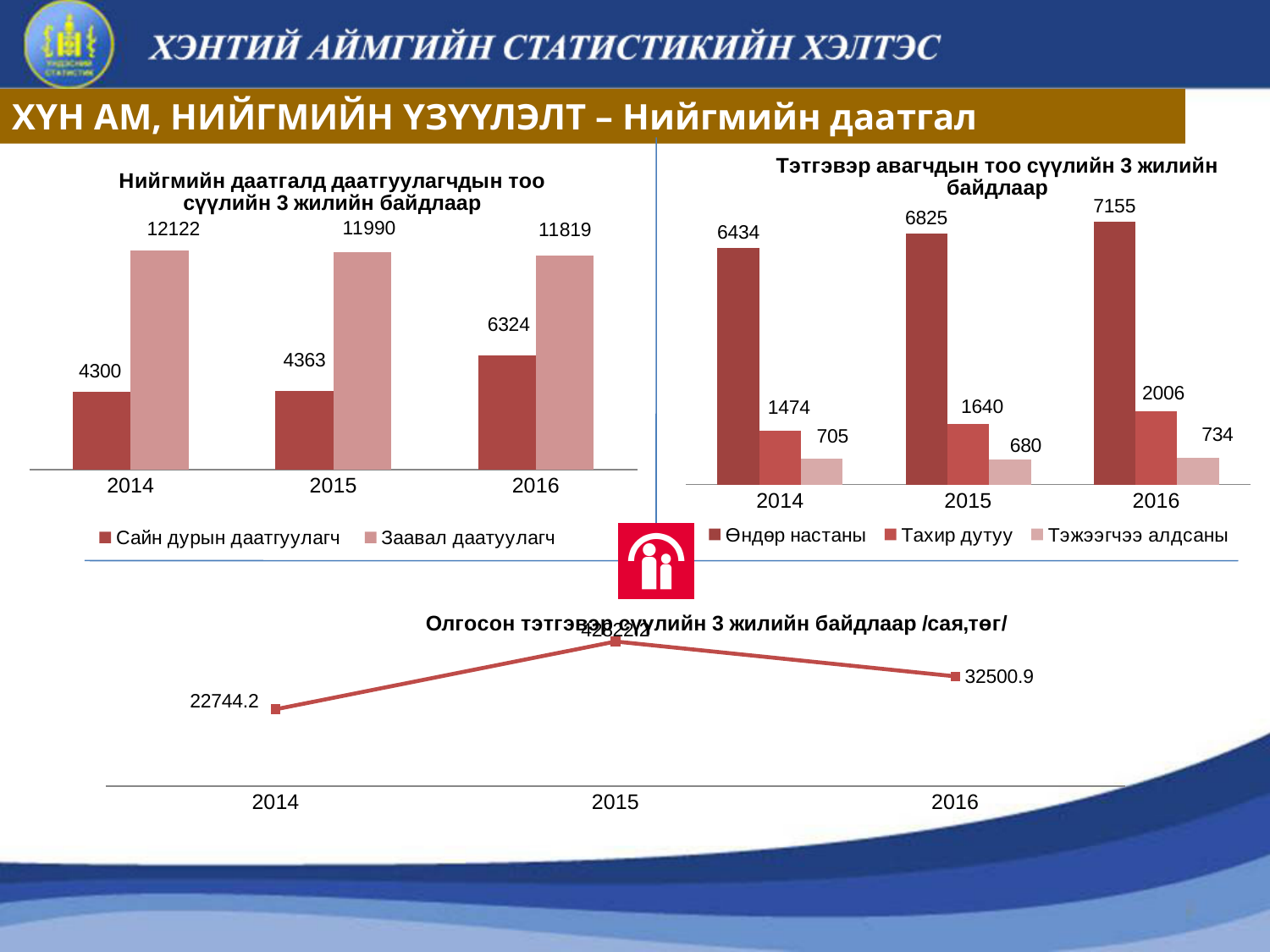
In the chart 'Тэтгэвэр авагчдын тоо сүүлийн 3 жилийн байдлаар', what is the value for Өндөр настаны in 2016? 7155 In the chart 'Тэтгэвэр авагчдын тоо сүүлийн 3 жилийн байдлаар', which year has the highest value for Тахир дутуу? 2016 In the chart 'Тэтгэвэр авагчдын тоо сүүлийн 3 жилийн байдлаар', which year has the lowest value for Тэжээгчээ алдсаны? 2015 What kind of chart is 'Олгосон тэтгэвэр сүүлийн 3 жилийн байдлаар /сая,төг/'? line chart In the chart 'Нийгмийн даатгалд даатгуулагчдын тоо сүүлийн 3 жилийн байдлаар', what is the difference between Заавал даатуулагч and Сайн дурын даатгуулагч in 2015? 7627 In the chart 'Олгосон тэтгэвэр сүүлийн 3 жилийн байдлаар /сая,төг/', what is the value for 2016? 32500.9 In the chart 'Тэтгэвэр авагчдын тоо сүүлийн 3 жилийн байдлаар', what is the value for Тэжээгчээ алдсаны in 2015? 680 In the chart 'Нийгмийн даатгалд даатгуулагчдын тоо сүүлийн 3 жилийн байдлаар', do the values for Заавал даатуулагч rise or fall from 2014 to 2016? fall In the chart 'Нийгмийн даатгалд даатгуулагчдын тоо сүүлийн 3 жилийн байдлаар', what is the value for Заавал даатуулагч in 2014? 12122 In the chart 'Нийгмийн даатгалд даатгуулагчдын тоо сүүлийн 3 жилийн байдлаар', what is the value for Сайн дурын даатгуулагч in 2016? 6324 How many series does the legend of the chart 'Нийгмийн даатгалд даатгуулагчдын тоо сүүлийн 3 жилийн байдлаар' list? 2 In the chart 'Тэтгэвэр авагчдын тоо сүүлийн 3 жилийн байдлаар', what is the difference between Өндөр настаны in 2016 and in 2014? 721